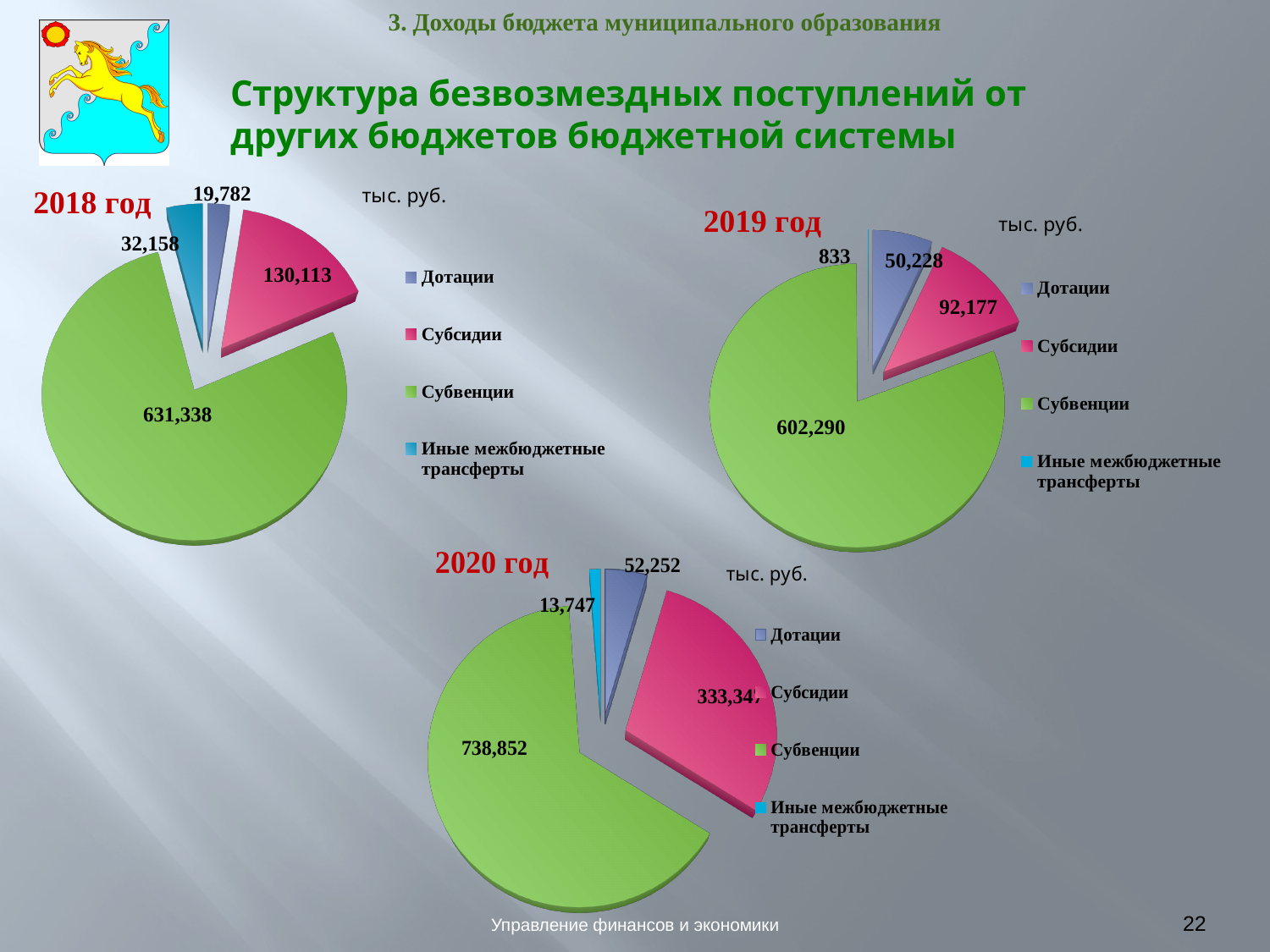
What type of chart is used for the 2020 год data? Pie chart In the 2020 год pie chart, what is the value for Субвенции? 738,852 In the 2020 год pie chart, which is larger: Дотации or Иные межбюджетные трансферты? Дотации In the 2019 год pie chart, which category has the smallest value? Иные межбюджетные трансферты In the 2018 год pie chart, what is the difference between Субсидии and Дотации? 110,331 In the 2018 год pie chart, what is the value for Субвенции? 631,338 What is the total of all four values in the 2019 год pie chart? 745,528 In the 2018 год pie chart, what is the value for Иные межбюджетные трансферты? 32,158 In the 2019 год pie chart, what is the value for Дотации? 50,228 In the 2018 год pie chart, which category has the largest value? Субвенции In the 2019 год pie chart, what is the difference between Субвенции and Субсидии? 510,113 How many categories does the legend of the 2018 год chart list? 4